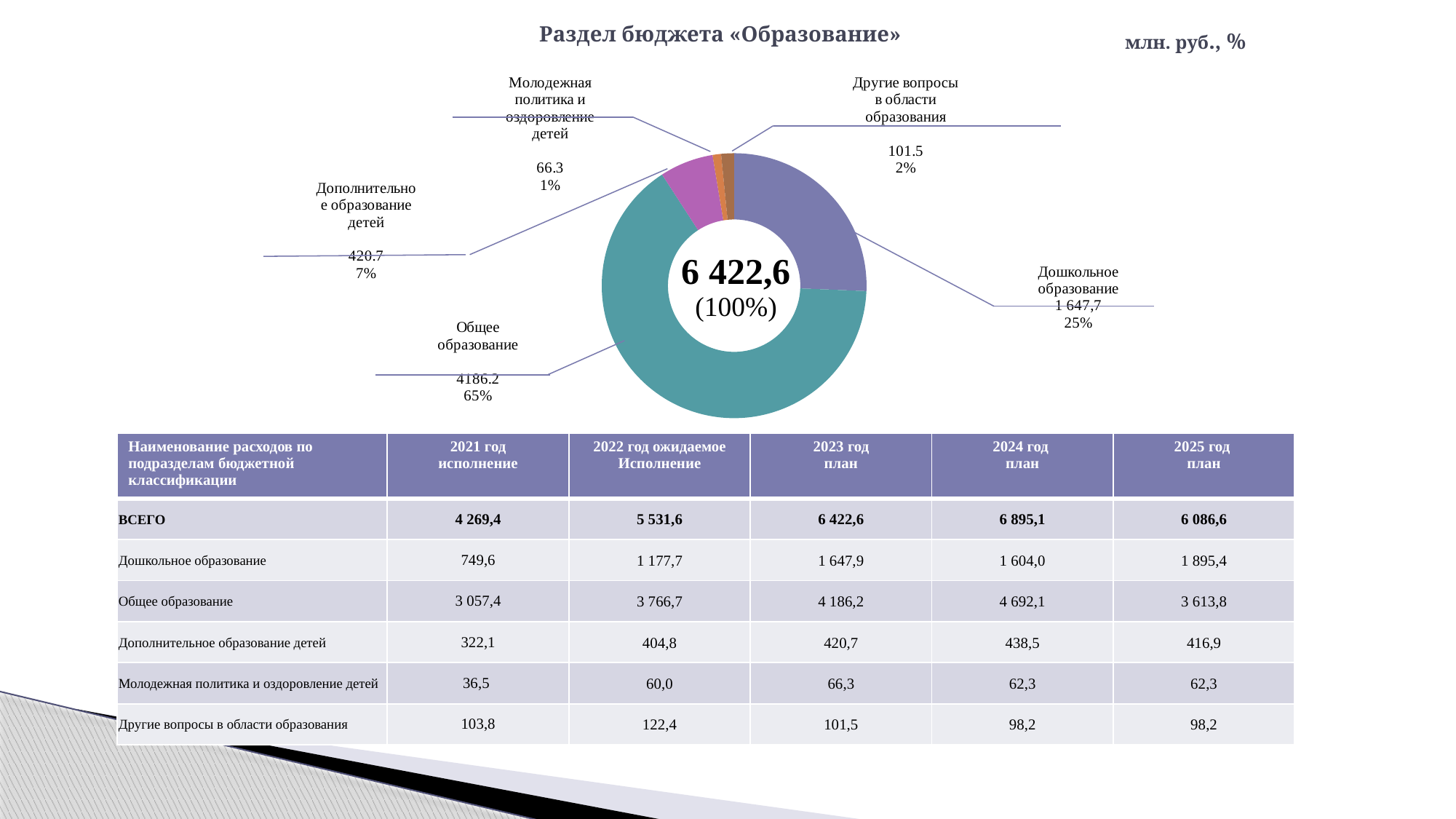
What share of the chart does Дошкольное образование represent? 25% What share of the chart does Общее образование represent? 65% What total value is shown in the centre of the chart? 6 422,6 What value is shown for Дошкольное образование on the chart? 1 647,7 What value is shown for Общее образование on the chart? 4186.2 What type of chart is shown on the slide? Pie (donut) chart How many categories are shown in the chart? 5 Which category has the largest slice in the chart? Общее образование What value is shown for Молодежная политика и оздоровление детей on the chart? 66.3 Which category has the smallest slice in the chart? Молодежная политика и оздоровление детей What value is shown for Дополнительное образование детей on the chart? 420.7 What share of the chart does Другие вопросы в области образования represent? 2%